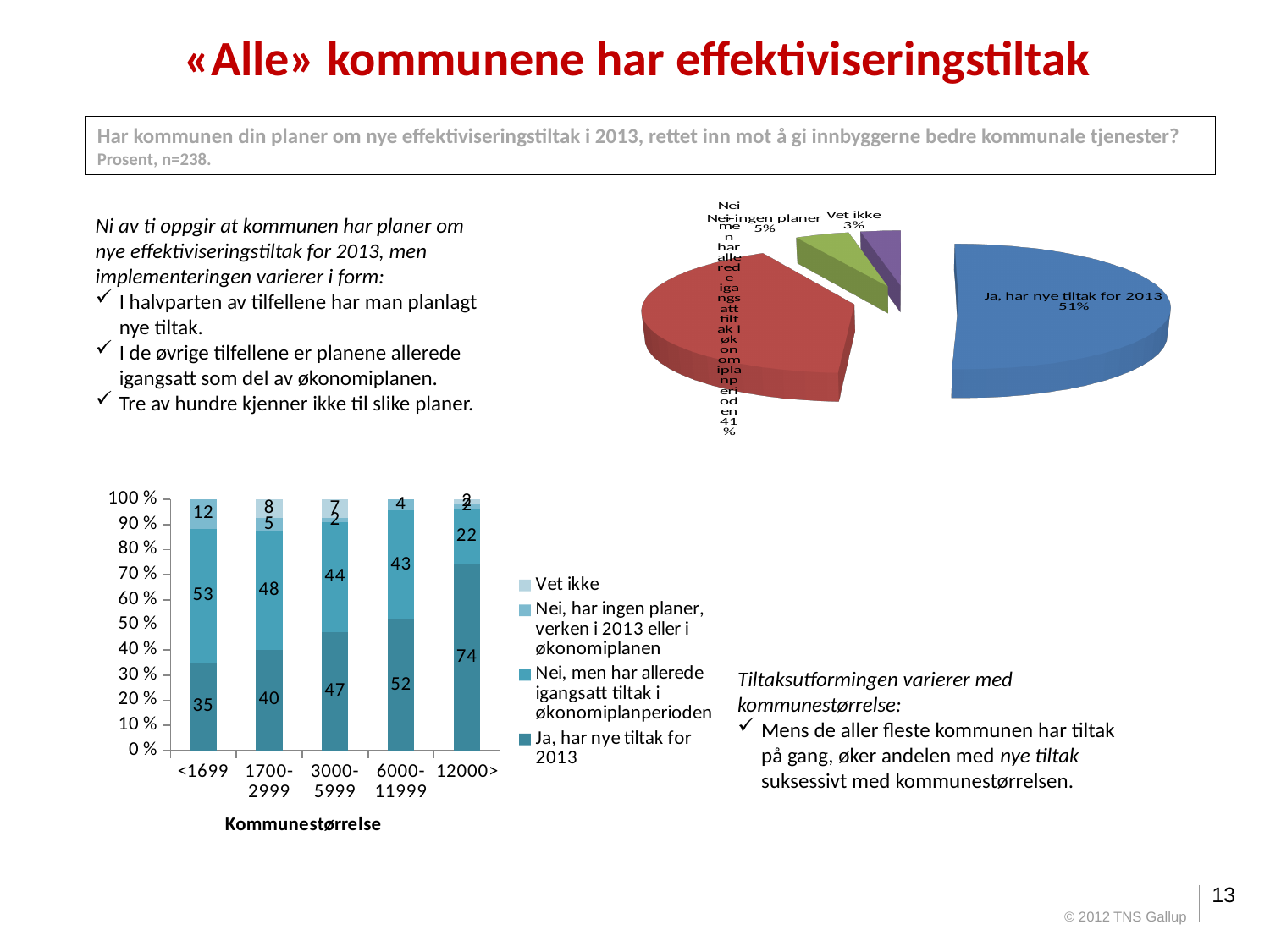
How many municipality size categories are shown on the x axis of the bar chart? 5 In the pie chart, what share of municipalities answered "Ja, har nye tiltak for 2013"? 51% In the pie chart, which category has the smallest slice? Vet ikke In the pie chart, what share of municipalities answered "Vet ikke"? 3% In the bar chart, what is the value of "Nei, men har allerede igangsatt tiltak i økonomiplanperioden" for municipalities of size <1699? 53 In the bar chart, which municipality size has the highest value for "Ja, har nye tiltak for 2013"? 12000> What kind of chart is the chart in the top right of the slide? Pie chart What kind of chart is the chart in the bottom left of the slide? Stacked bar chart In the pie chart, which category has the largest slice? Ja, har nye tiltak for 2013 In the bar chart, what is the value of "Ja, har nye tiltak for 2013" for municipalities of size 12000>? 74 In the bar chart, what is the difference between the "Ja, har nye tiltak for 2013" values for 12000> and <1699? 39 In the bar chart, does the value of "Ja, har nye tiltak for 2013" rise or fall as municipality size increases? Rises